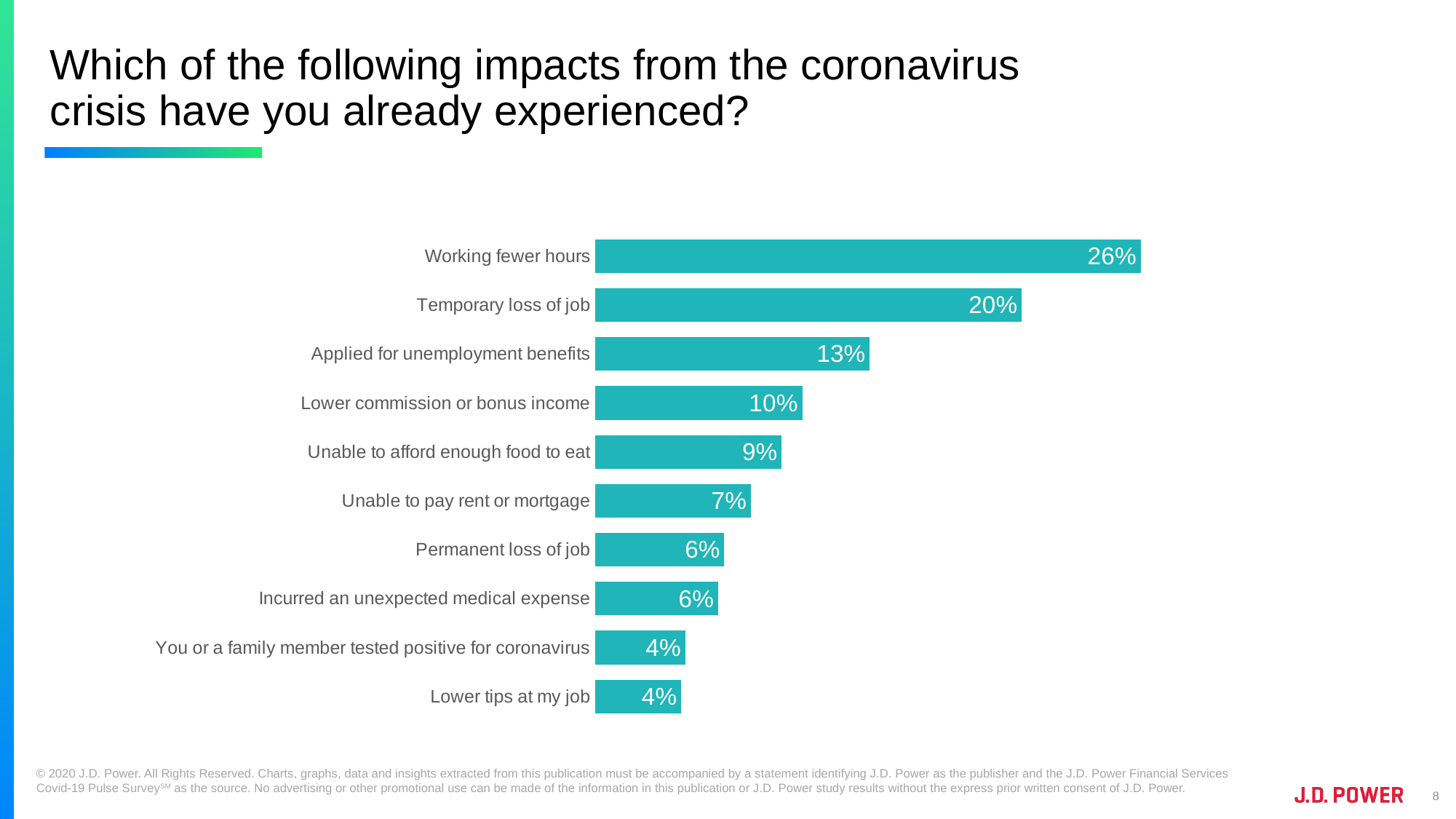
What is the value for 'Applied for unemployment benefits'? 13% What is the difference between 'Working fewer hours' and 'Temporary loss of job'? 6 percentage points What percentage of respondents reported working fewer hours? 26% What colour are the bars in the chart? Teal How many impact categories are shown in the chart? 10 Which is larger: 'Temporary loss of job' or 'Applied for unemployment benefits'? Temporary loss of job What is the difference between 'Temporary loss of job' and 'Permanent loss of job'? 14 percentage points What is the value for 'Lower tips at my job'? 4% What percentage reported being unable to pay rent or mortgage? 7% Which is larger: 'Lower commission or bonus income' or 'Unable to afford enough food to eat'? Lower commission or bonus income Which impact has the highest percentage? Working fewer hours What type of chart is shown on the slide? Bar chart